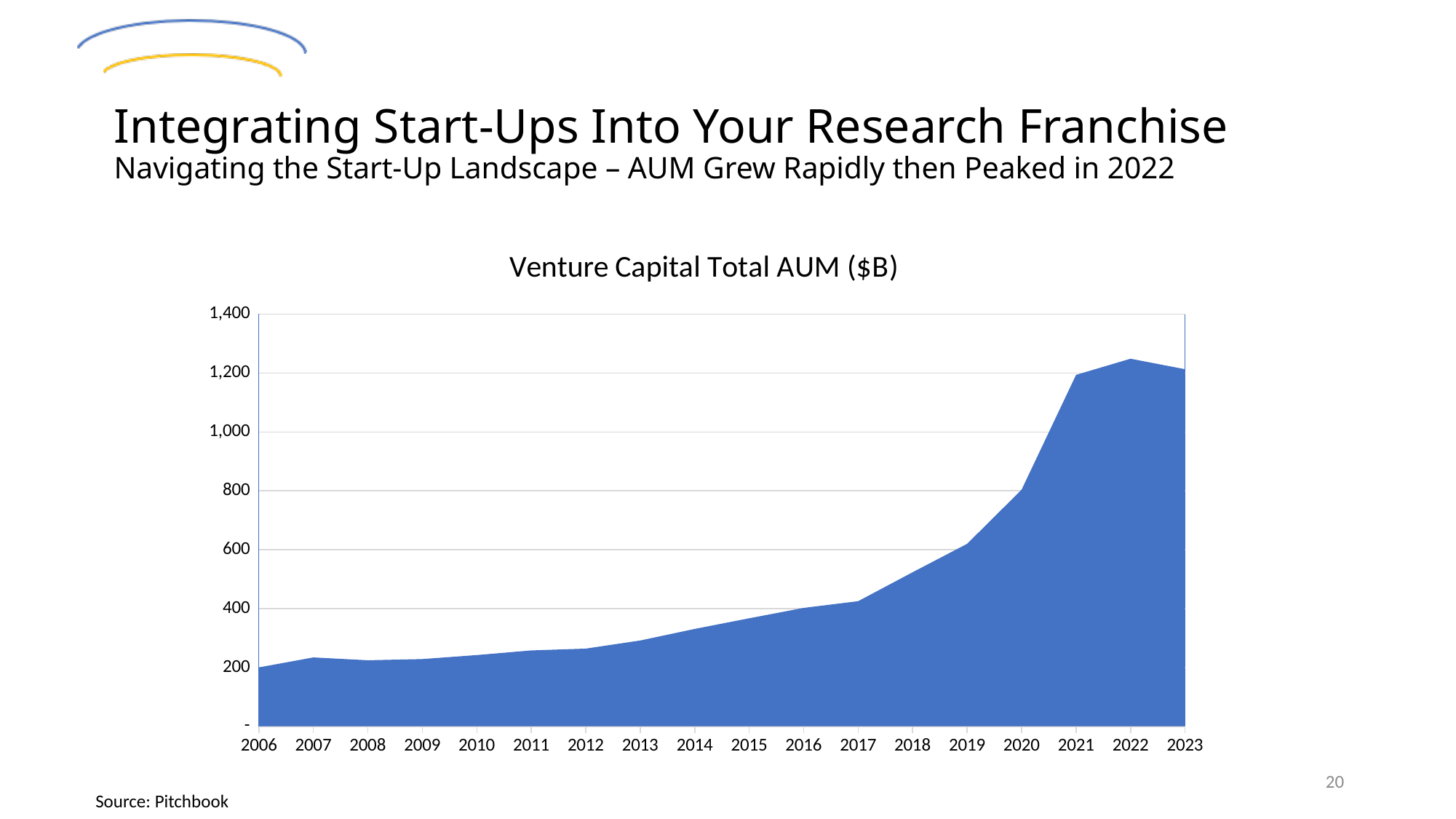
Is the value for 2019 greater or less than 400? greater Is the value for 2013 greater or less than 400? less Which year has the lowest Venture Capital Total AUM? 2006 How many years are plotted along the x axis of the chart? 18 What kind of chart is shown on the slide? Area chart Is the value for 2021 greater or less than 1,000? greater Does Venture Capital Total AUM generally rise or fall from 2006 to 2022? rise What is the title of the chart? Venture Capital Total AUM ($B) Which year has the larger Venture Capital Total AUM, 2020 or 2021? 2021 Which year has the highest Venture Capital Total AUM? 2022